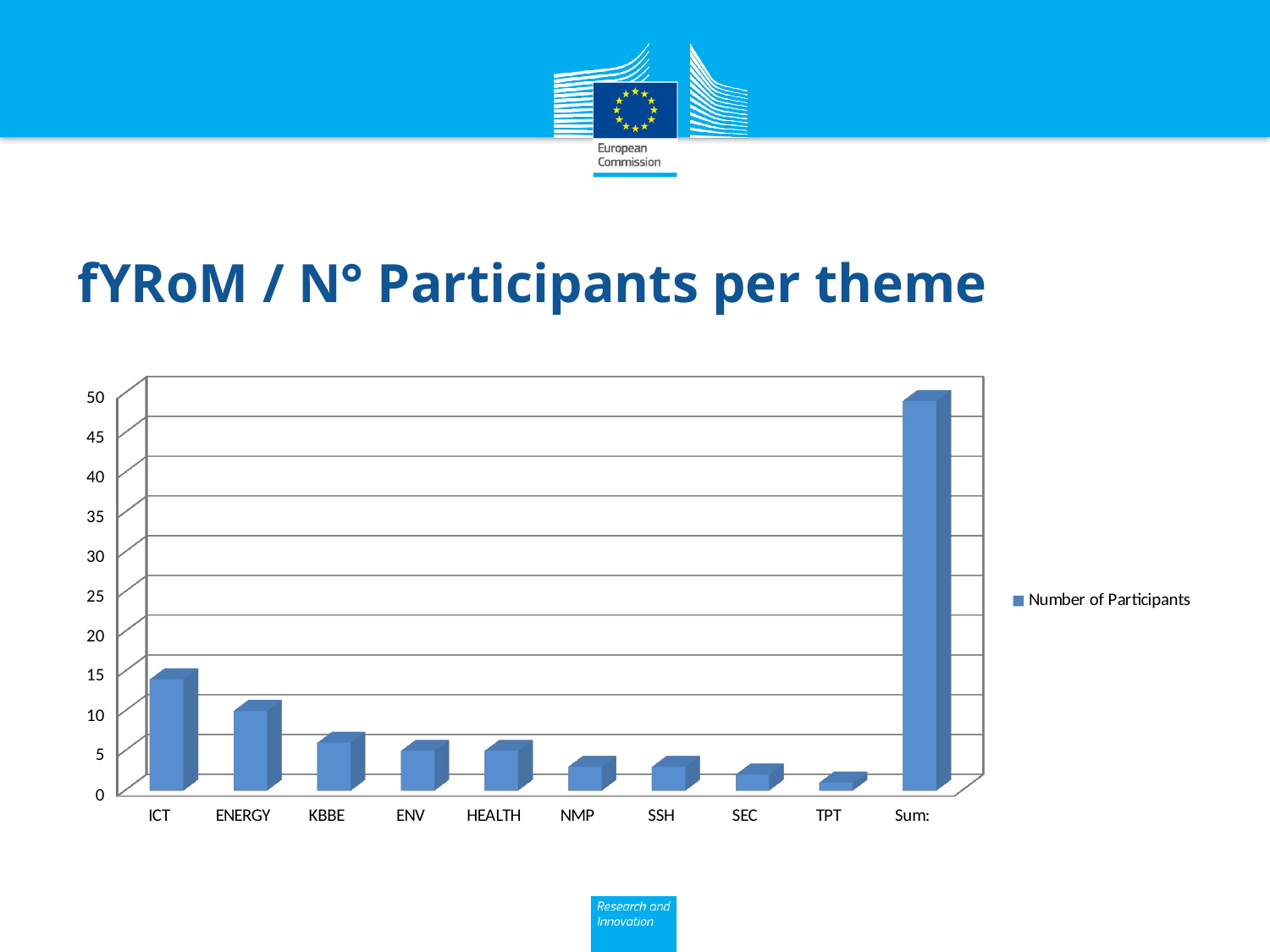
What kind of chart is shown on the slide? bar chart Is the value for Sum: greater or less than 45? greater Is the value for ICT greater or less than 10? greater What is the name of the series listed in the legend? Number of Participants Is the value for TPT greater or less than 5? less Which category has the tallest bar in the chart? Sum: How many categories are shown on the x axis of the chart? 10 Excluding the Sum: bar, which theme has the highest number of participants? ICT Which has more participants, KBBE or NMP? KBBE How many series does the legend list? 1 Which theme has the lowest number of participants? TPT Which has more participants, ICT or ENERGY? ICT